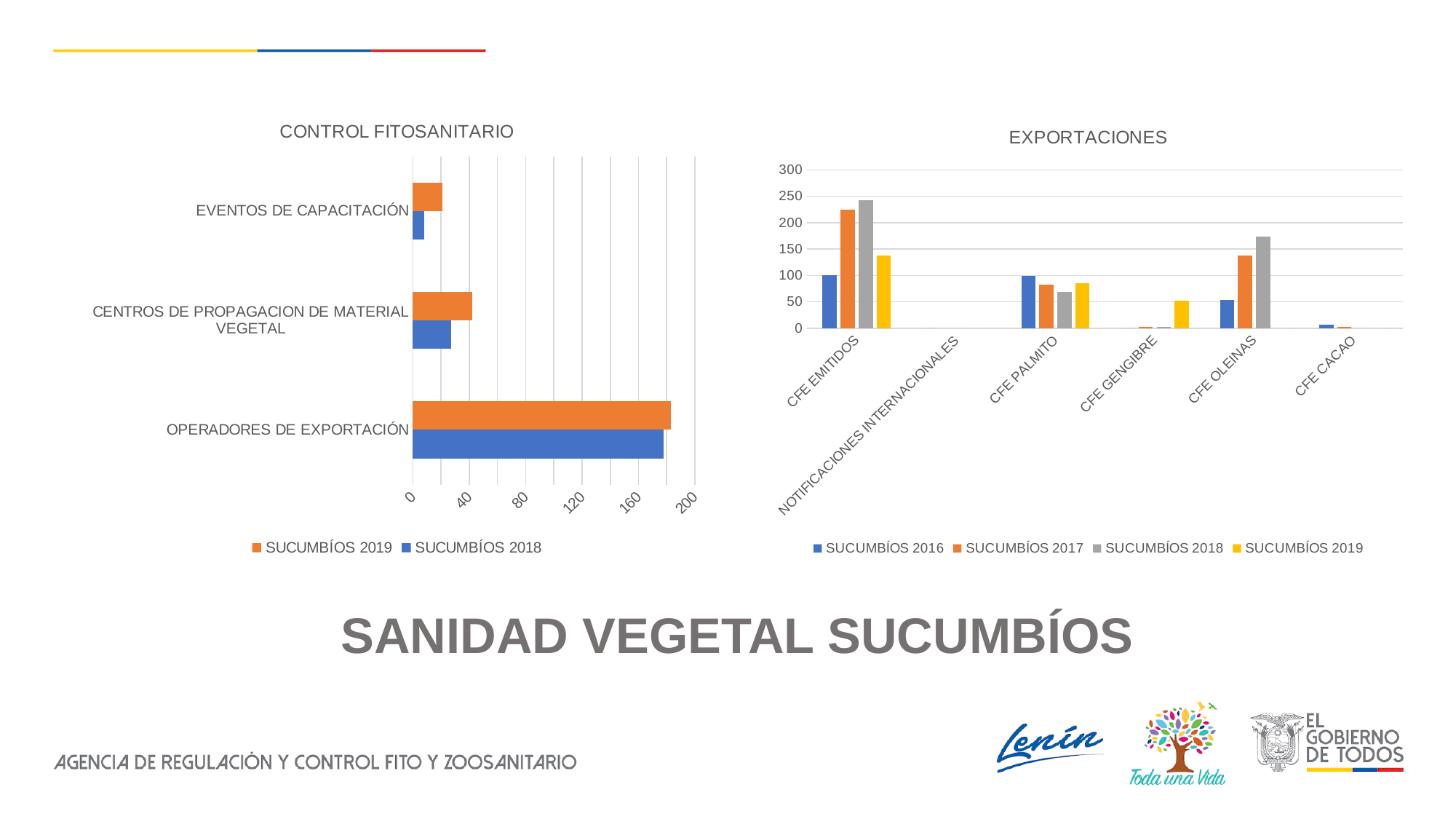
In the CONTROL FITOSANITARIO chart, what kind of chart is used? bar chart In the CONTROL FITOSANITARIO chart, is the SUCUMBÍOS 2019 value for OPERADORES DE EXPORTACIÓN greater or less than 160? greater In the CONTROL FITOSANITARIO chart, which category has the highest value for SUCUMBÍOS 2019? OPERADORES DE EXPORTACIÓN In the CONTROL FITOSANITARIO chart, for CENTROS DE PROPAGACION DE MATERIAL VEGETAL, which series has the larger value, SUCUMBÍOS 2019 or SUCUMBÍOS 2018? SUCUMBÍOS 2019 In the EXPORTACIONES chart, which category has the larger SUCUMBÍOS 2017 value, CFE EMITIDOS or CFE OLEINAS? CFE EMITIDOS In the EXPORTACIONES chart, how many series does the legend list? 4 In the CONTROL FITOSANITARIO chart, is the SUCUMBÍOS 2018 value for CENTROS DE PROPAGACION DE MATERIAL VEGETAL greater or less than 40? less In the EXPORTACIONES chart, which series has the highest value for CFE EMITIDOS? SUCUMBÍOS 2018 In the EXPORTACIONES chart, is the SUCUMBÍOS 2018 value for CFE OLEINAS greater or less than 150? greater In the EXPORTACIONES chart, how many categories are shown on the x axis? 6 In the CONTROL FITOSANITARIO chart, how many series does the legend list? 2 In the CONTROL FITOSANITARIO chart, how many categories are shown? 3